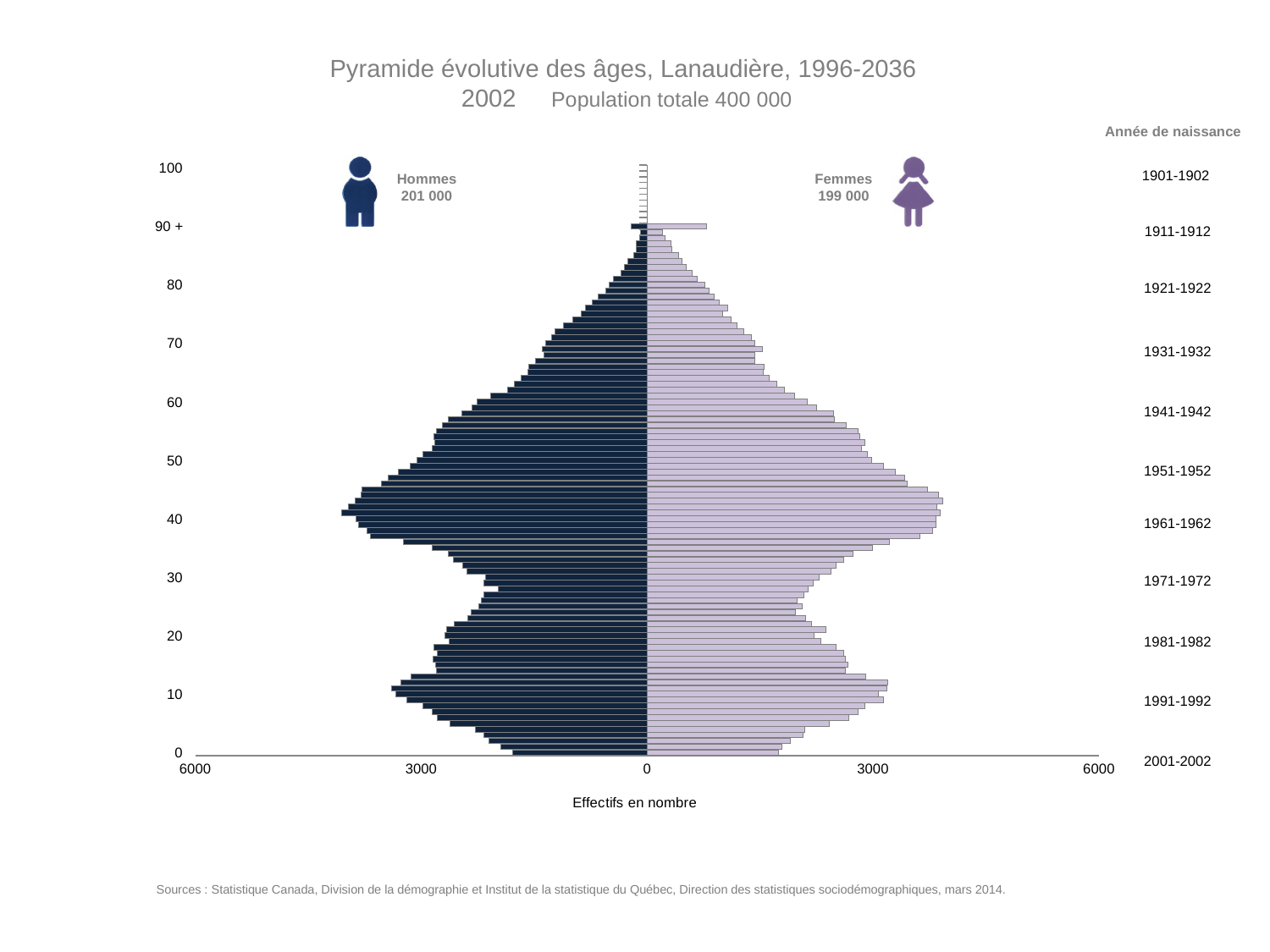
What is the difference between the number of Hommes and the number of Femmes? 2 000 What is the total population shown for 2002? 400 000 Which group is larger, Hommes or Femmes? Hommes What is the number of Femmes shown on the chart? 199 000 Is the value for Hommes at age 80 greater or less than 3000? less What kind of chart is shown on the slide? bar chart Is the value for Hommes at age 40 greater or less than 3000? greater What is the number of Hommes shown on the chart? 201 000 Which year does the pyramid shown on the slide represent? 2002 Is the value for Femmes at age 70 greater or less than 3000? less What is the title of the chart? Pyramide évolutive des âges, Lanaudière, 1996-2036 What is the label of the horizontal axis? Effectifs en nombre